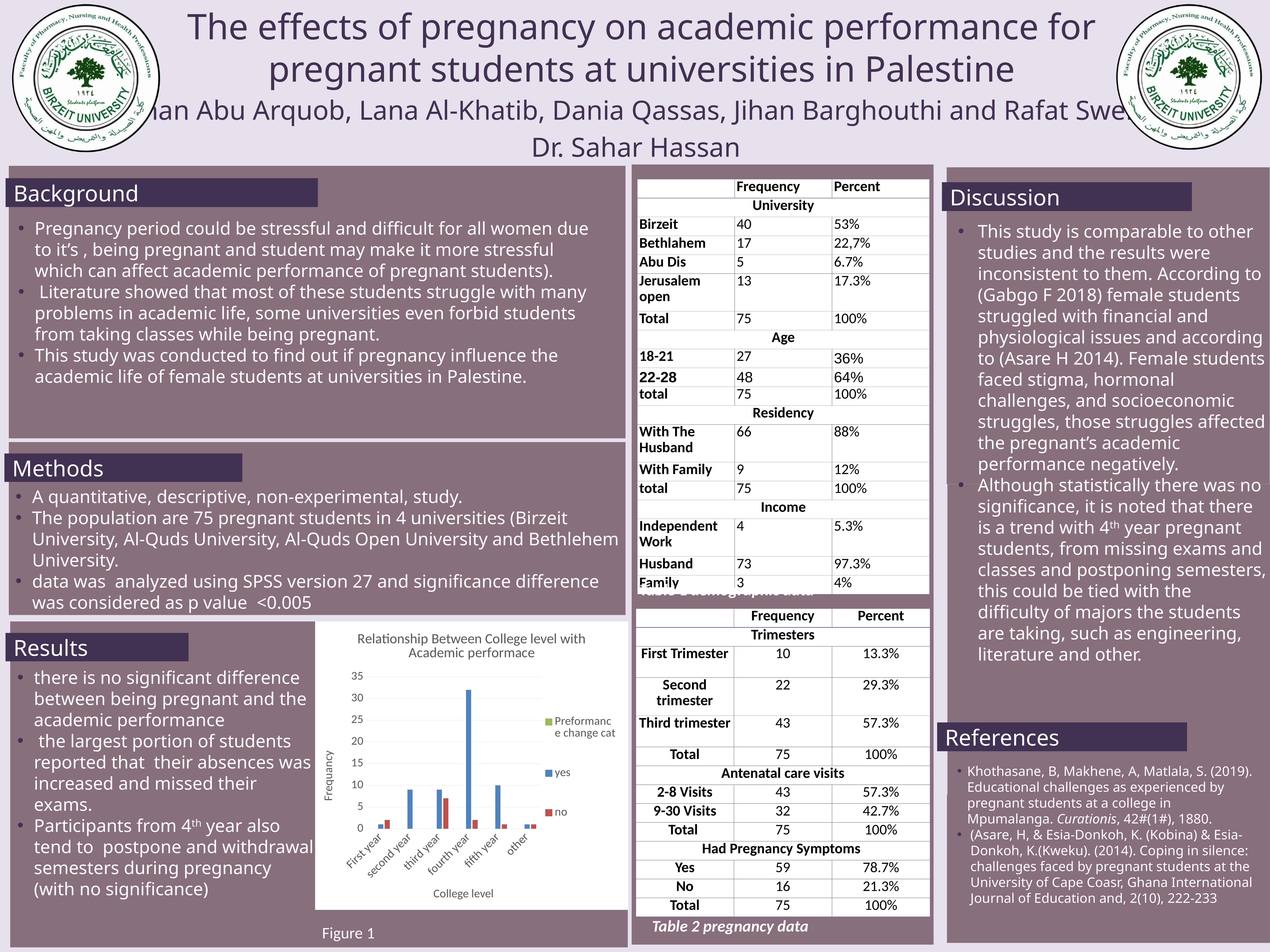
Is the 'yes' value for second year greater or less than 15? less Which college level has the highest 'yes' bar in the chart? fourth year Is the 'no' value for third year greater or less than 5? greater Is the 'yes' value for fourth year greater or less than 30? greater Which is larger for third year: the 'yes' bar or the 'no' bar? yes What is the label of the chart's x axis? College level How many college level categories are shown on the x axis of the chart? 6 What kind of chart is shown in Figure 1? bar chart Which is larger in the chart: the 'yes' value for fourth year or the 'yes' value for third year? fourth year What is the title of the chart in Figure 1? Relationship Between College level with Academic performace How many entries does the chart's legend list? 3